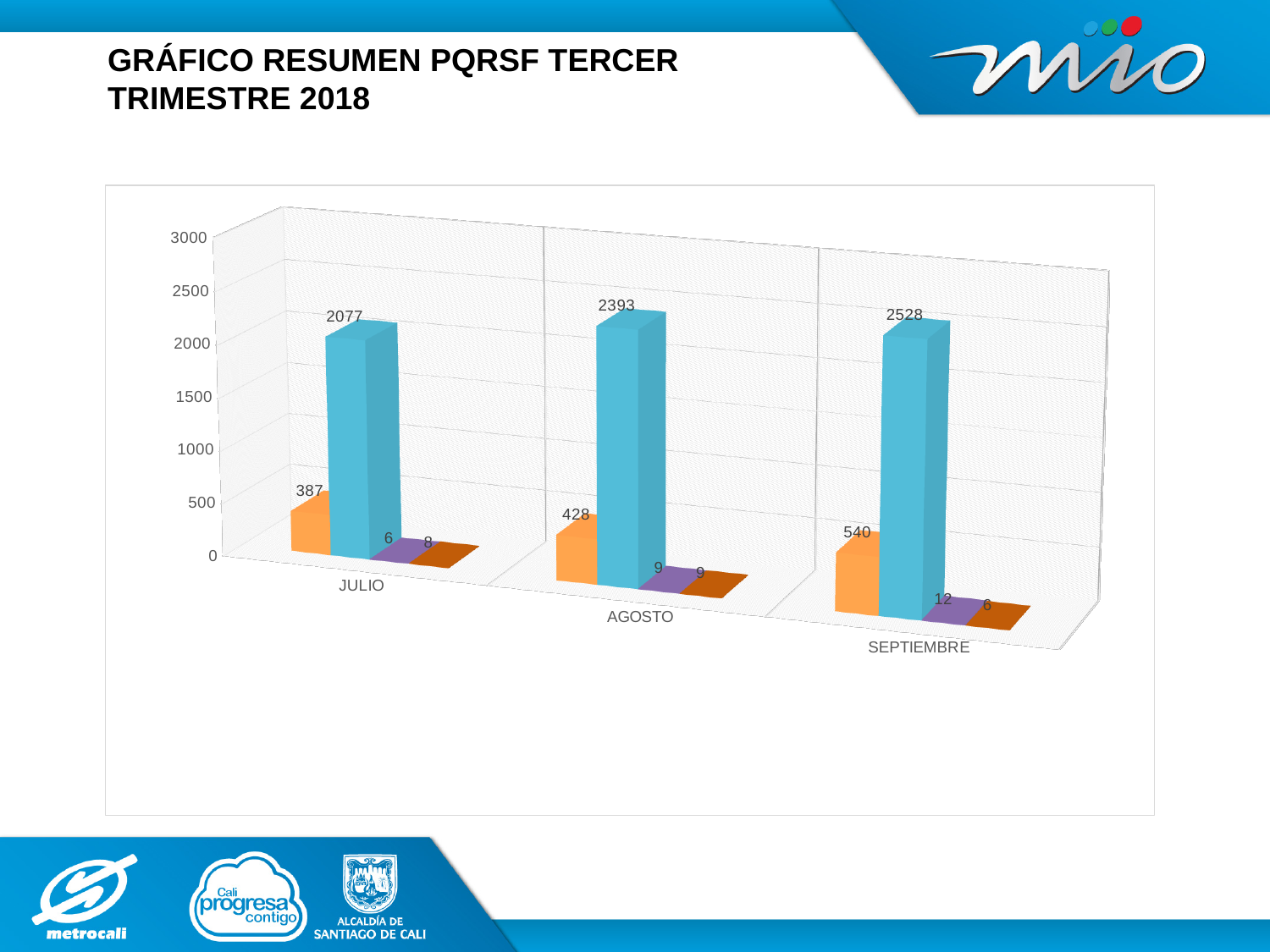
What is the value of the orange bar for SEPTIEMBRE? 540 What is the value of the tallest (blue) bar for AGOSTO? 2393 In which month is the blue bar highest? SEPTIEMBRE What is the value of the tallest (blue) bar for SEPTIEMBRE? 2528 What is the value of the orange bar for JULIO? 387 Do the blue bar values rise or fall from JULIO to SEPTIEMBRE? rise What type of chart is shown on the slide? bar chart What is the difference between the blue bar values for SEPTIEMBRE and JULIO? 451 In which month is the orange bar lowest? JULIO How many months (categories) are shown on the x axis of the chart? 3 What is the value of the tallest (blue) bar for JULIO? 2077 Which is larger, the orange bar for AGOSTO or the orange bar for SEPTIEMBRE? SEPTIEMBRE